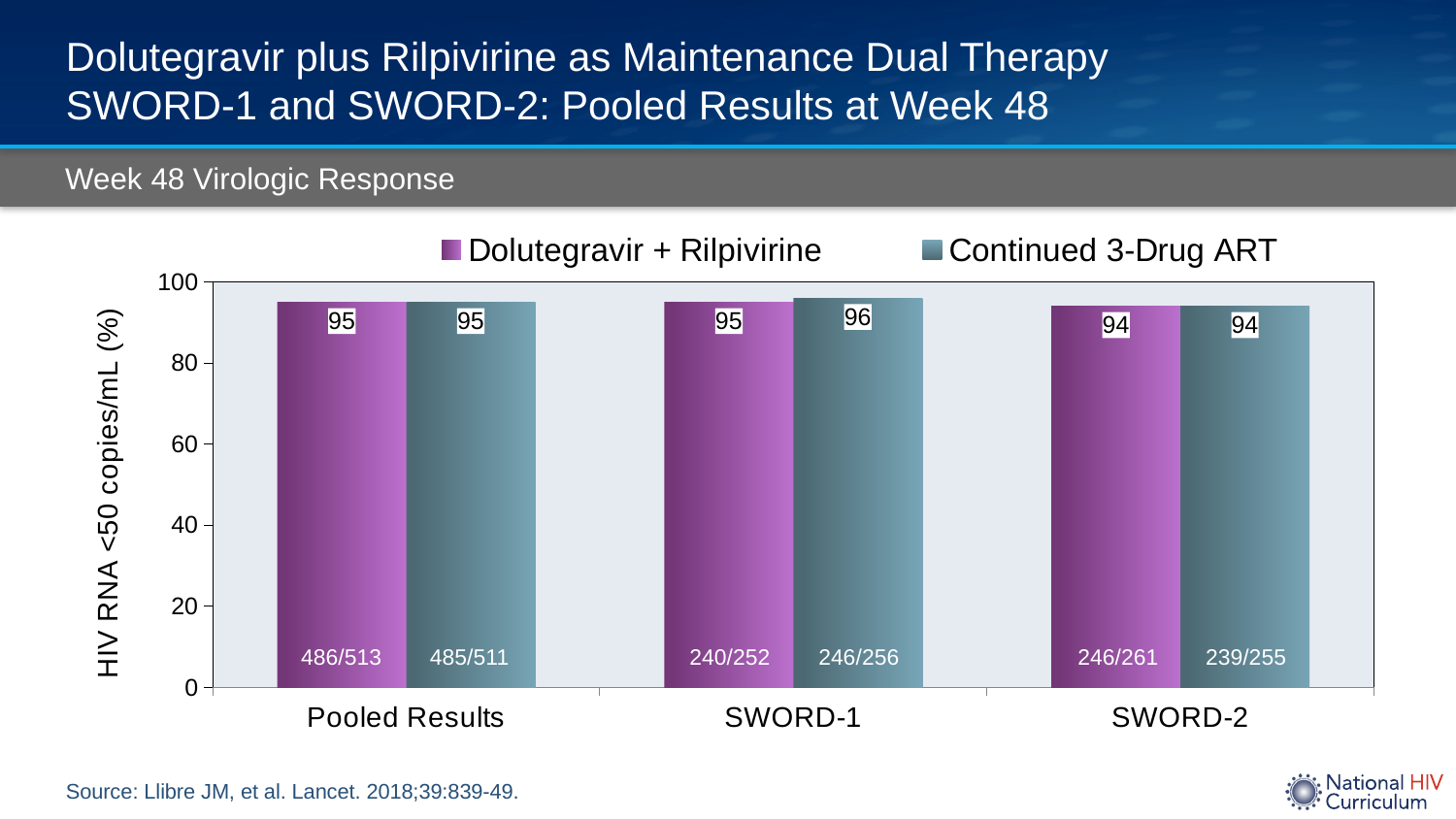
What fraction is printed on the Continued 3-Drug ART bar for Pooled Results? 485/511 How many series does the legend list? 2 What is the difference between the Continued 3-Drug ART value and the Dolutegravir + Rilpivirine value in SWORD-1? 1 How many categories are shown on the x axis? 3 What is the label of the y axis? HIV RNA <50 copies/mL (%) What is the value for Continued 3-Drug ART in SWORD-1? 96 What fraction is printed on the Dolutegravir + Rilpivirine bar for SWORD-1? 240/252 Is the value for Dolutegravir + Rilpivirine in SWORD-2 greater or less than 80? greater What is the value for Dolutegravir + Rilpivirine in the Pooled Results category? 95 What is the value for Continued 3-Drug ART in SWORD-2? 94 What kind of chart is shown on the slide? Bar chart What is the value for Dolutegravir + Rilpivirine in SWORD-2? 94